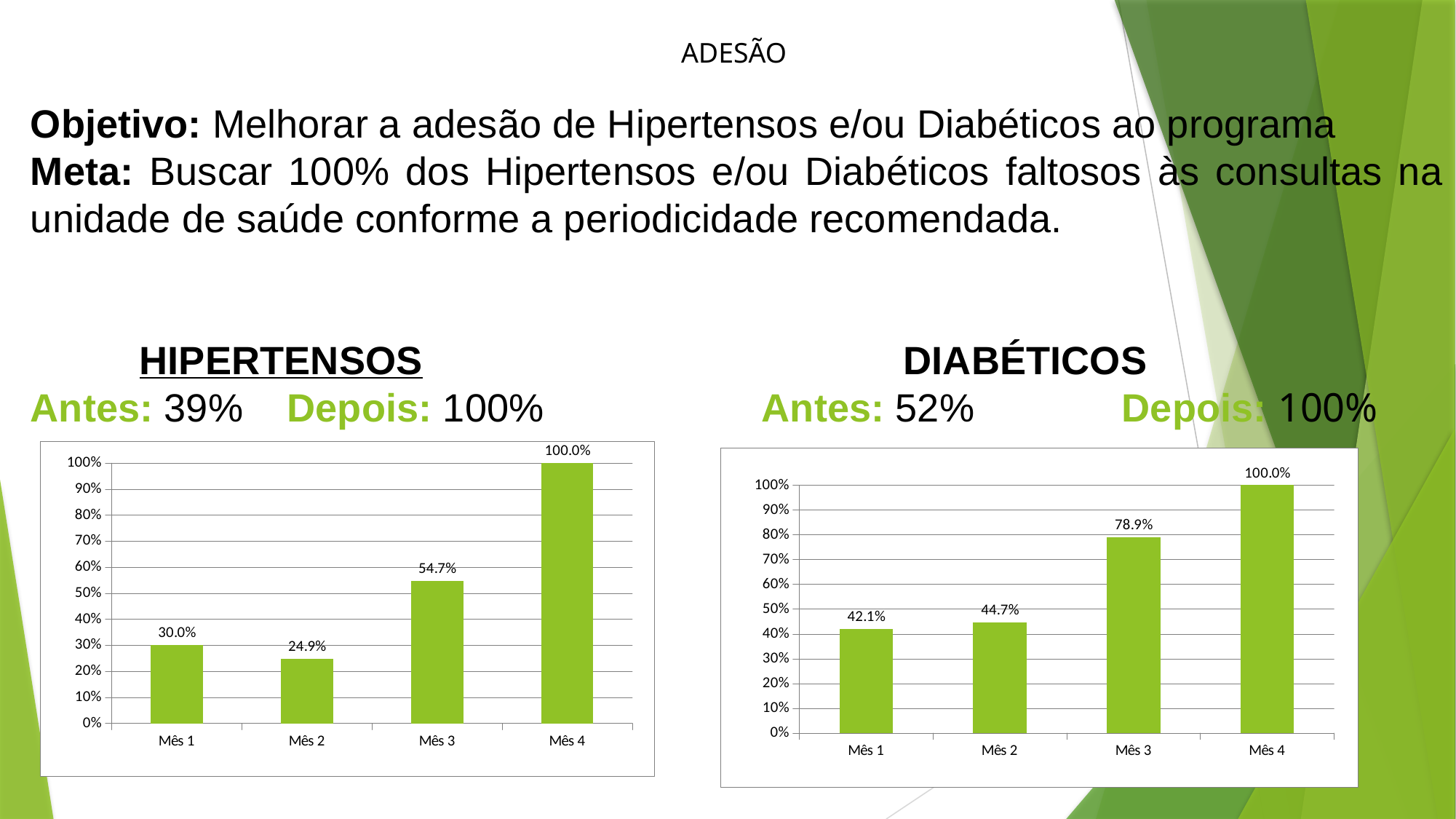
What kind of chart is the HIPERTENSOS chart? Bar chart In the HIPERTENSOS chart, which month has the lowest value? Mês 2 In the DIABÉTICOS chart, is the value for Mês 2 larger than the value for Mês 1? Yes In the DIABÉTICOS chart, what is the difference between Mês 4 and Mês 3? 21.1% In the DIABÉTICOS chart, do the values rise or fall from Mês 1 to Mês 4? Rise In the DIABÉTICOS chart, which month has the highest value? Mês 4 In the HIPERTENSOS chart, what is the difference between Mês 3 and Mês 2? 29.8% In the HIPERTENSOS chart, what is the value for Mês 2? 24.9% In the HIPERTENSOS chart, what is the value for Mês 1? 30.0% In the HIPERTENSOS chart, how many months are plotted? 4 In the DIABÉTICOS chart, what is the value for Mês 1? 42.1% In the DIABÉTICOS chart, what is the value for Mês 3? 78.9%